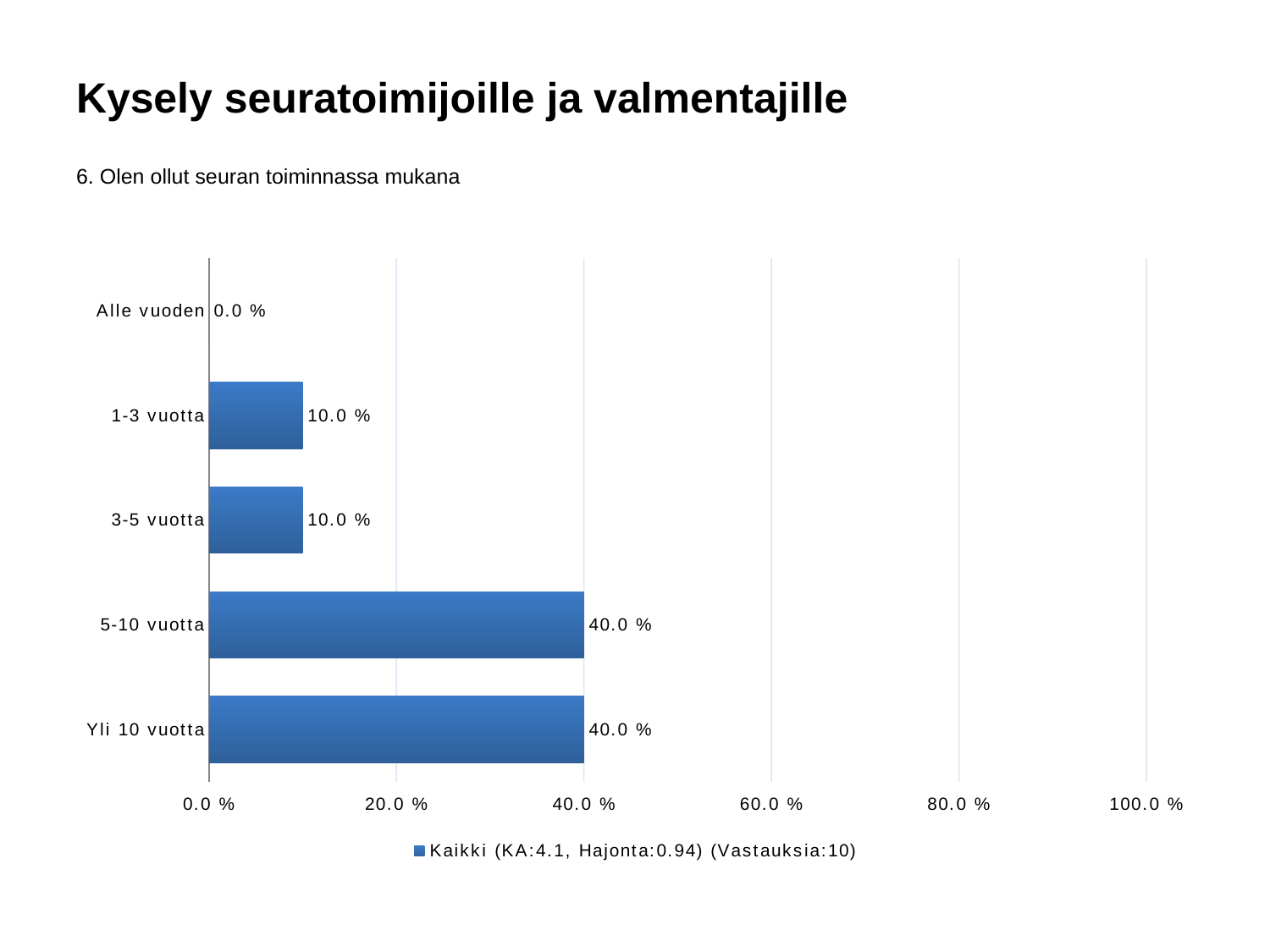
What is the highest value shown on the x axis? 100.0 % How many series does the legend list? 1 What is the difference between the values for "5-10 vuotta" and "3-5 vuotta"? 30.0 % What is the value for "Alle vuoden"? 0.0 % What is the value for "1-3 vuotta"? 10.0 % What is the value for "Yli 10 vuotta"? 40.0 % What is the value for "5-10 vuotta"? 40.0 % What is the legend entry for the series shown? Kaikki (KA:4.1, Hajonta:0.94) (Vastauksia:10) Which category has the lowest value? Alle vuoden How many categories are shown on the chart? 5 What kind of chart is shown on the slide? Bar chart Which is larger, the value for "Yli 10 vuotta" or the value for "1-3 vuotta"? Yli 10 vuotta